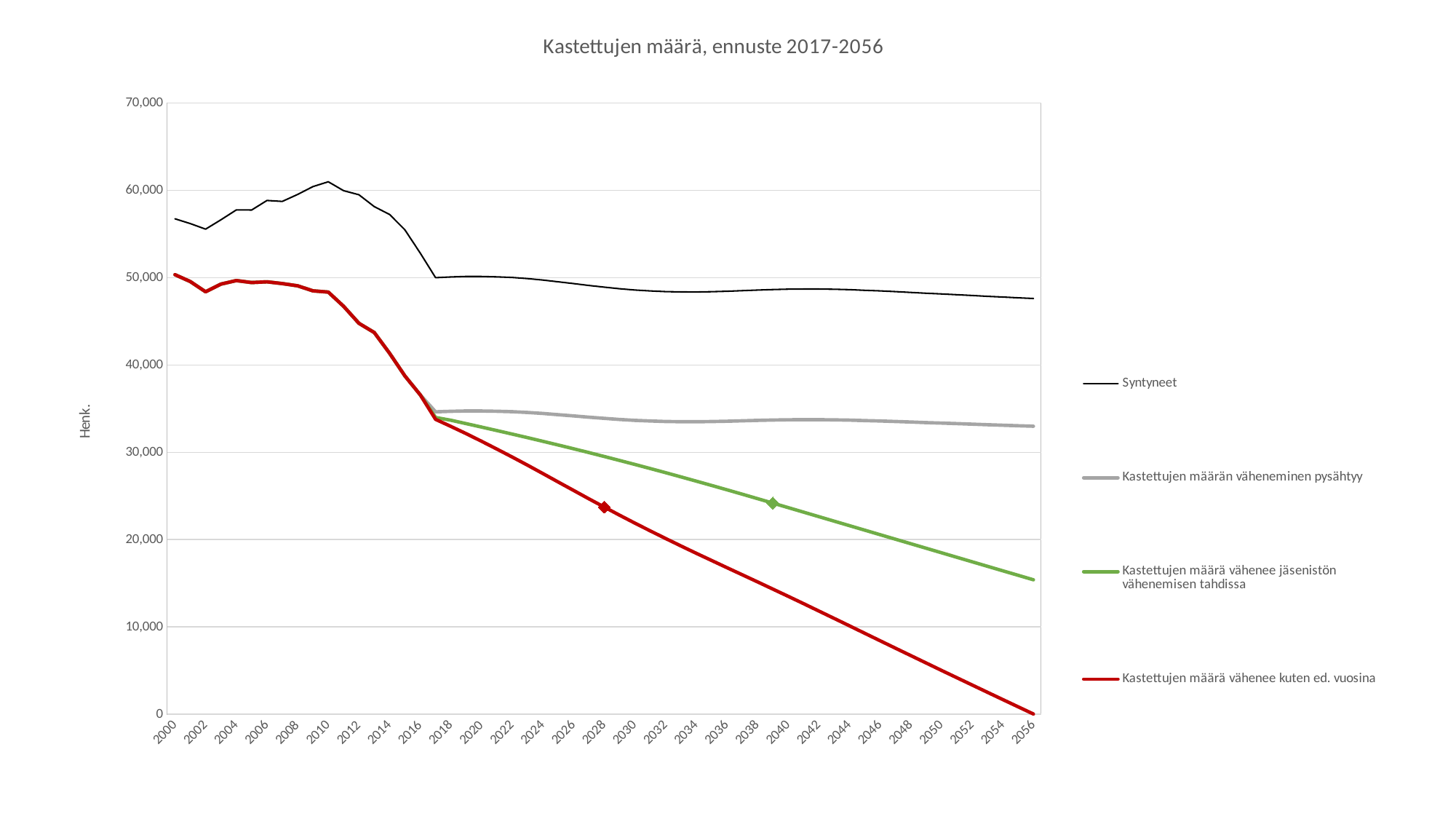
What is the label on the vertical axis? Henk. Which series has the lowest value in 2056? Kastettujen määrä vähenee kuten ed. vuosina Which series has the highest value in 2056? Syntyneet Is the value for 'Kastettujen määrän väheneminen pysähtyy' in 2056 greater or less than 30,000? greater Is the value for Syntyneet in 2000 greater or less than 60,000? less What is the title of the chart? Kastettujen määrä, ennuste 2017-2056 How many series does the legend list? 4 How many year labels are shown on the x axis? 29 In 2056, which is larger: 'Kastettujen määrän väheneminen pysähtyy' or 'Kastettujen määrä vähenee jäsenistön vähenemisen tahdissa'? Kastettujen määrän väheneminen pysähtyy Does the series 'Kastettujen määrä vähenee kuten ed. vuosina' rise or fall from 2018 to 2056? fall What kind of chart is shown on the slide? line chart